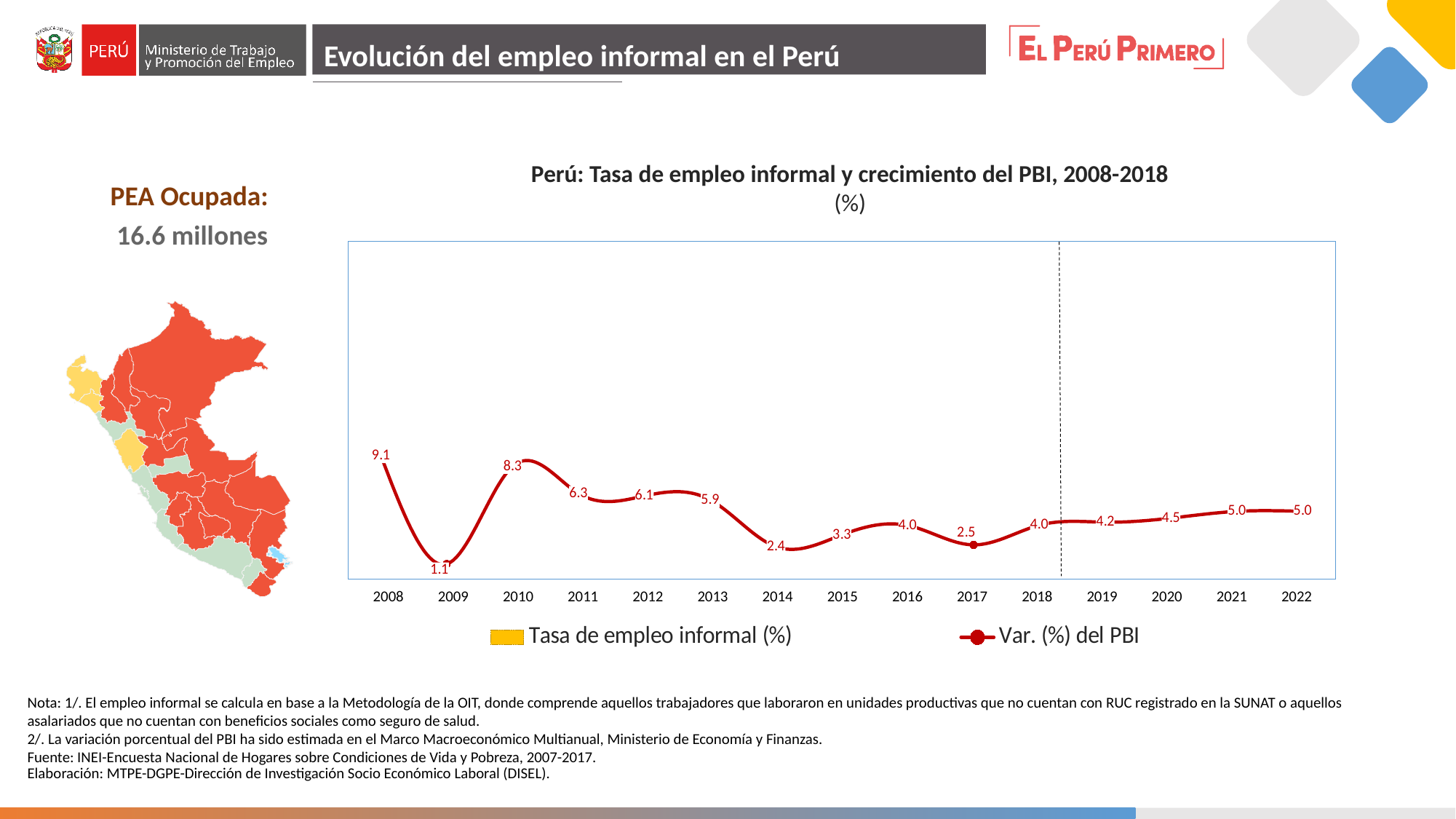
What is the difference between the Var. (%) del PBI values for 2010 and 2009? 7.2 What kind of chart is used to plot the Var. (%) del PBI series? Line chart In which year is the Var. (%) del PBI highest? 2008 How many years are shown on the x axis of the chart? 15 Which year has a larger Var. (%) del PBI value, 2013 or 2017? 2013 What is the Var. (%) del PBI value for 2014? 2.4 Does the Var. (%) del PBI rise or fall from 2018 to 2021? Rise What is the Var. (%) del PBI value for 2008? 9.1 What is the Var. (%) del PBI value for 2020? 4.5 In which year is the Var. (%) del PBI lowest? 2009 What is the title of the chart? Perú: Tasa de empleo informal y crecimiento del PBI, 2008-2018 (%) How many series does the legend list? 2